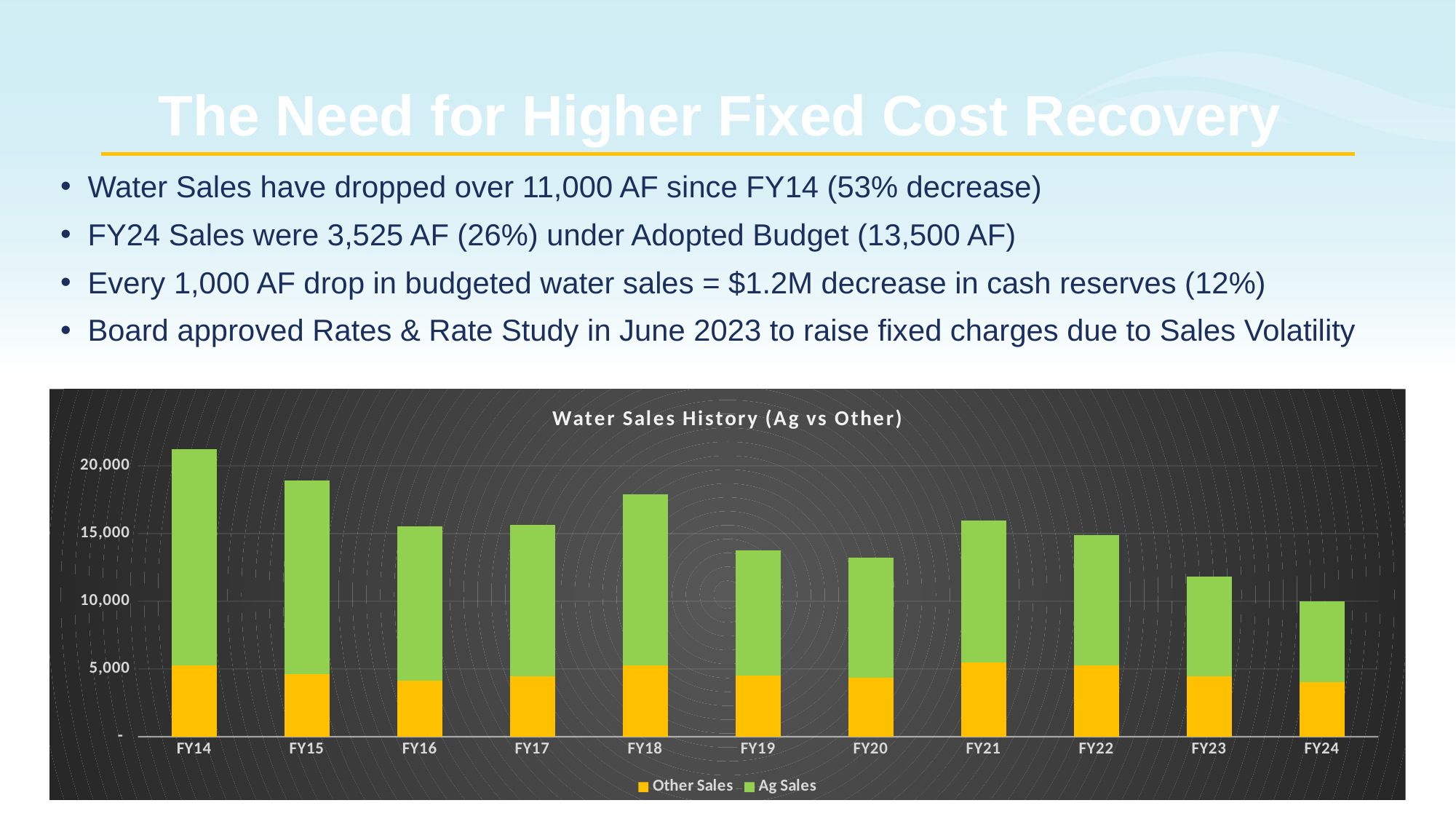
Is the total water sales value for FY14 greater or less than 20,000? greater How many series does the chart legend list? 2 What type of chart is shown on the slide? Stacked bar chart Do total water sales generally rise or fall from FY14 to FY24? fall Which colour represents Ag Sales in the chart? Green Which fiscal year has the lowest total water sales in the chart? FY24 What is the title of the chart? Water Sales History (Ag vs Other) Which fiscal year has larger total water sales, FY15 or FY18? FY15 Is the total water sales value for FY18 greater or less than 15,000? greater How many fiscal years are shown on the x axis of the chart? 11 Which fiscal year has the highest total water sales in the chart? FY14 Is the total water sales value for FY23 greater or less than 15,000? less